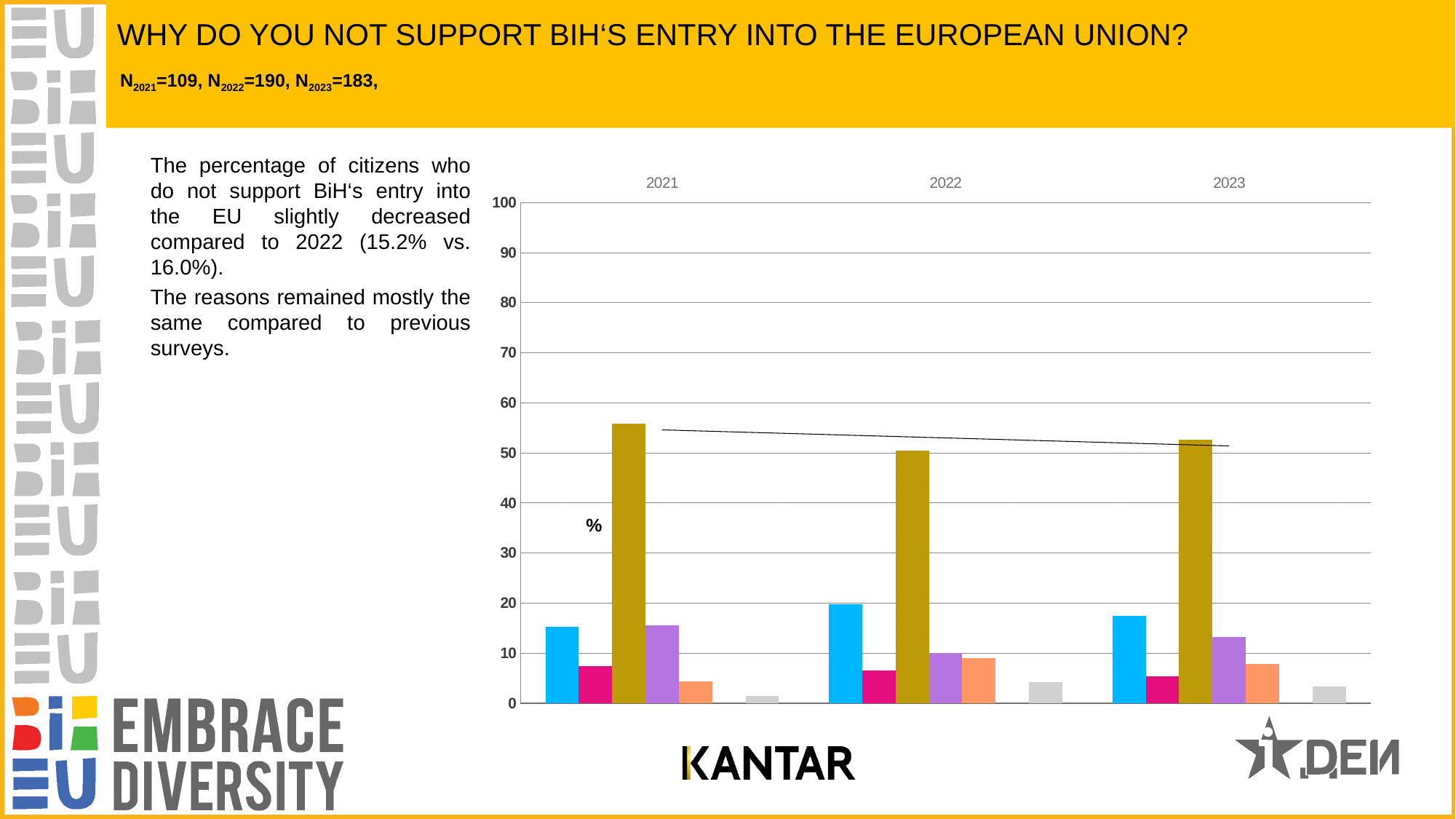
In which year group is the tallest bar on the chart the highest? 2021 How many year categories are shown on the x axis of the chart? 3 Is the tallest bar in the 2021 group higher or lower than the tallest bar in the 2022 group? higher Is the tallest bar in the 2022 group greater or less than 60? less Is the tallest bar in the 2021 group greater or less than 50? greater Is the shortest bar in the 2021 group greater or less than 10? less How many bars are plotted in the 2021 group? 6 What is the maximum value shown on the chart's vertical axis? 100 What kind of chart is shown on the slide? bar chart Which years are shown as categories on the chart? 2021, 2022, 2023